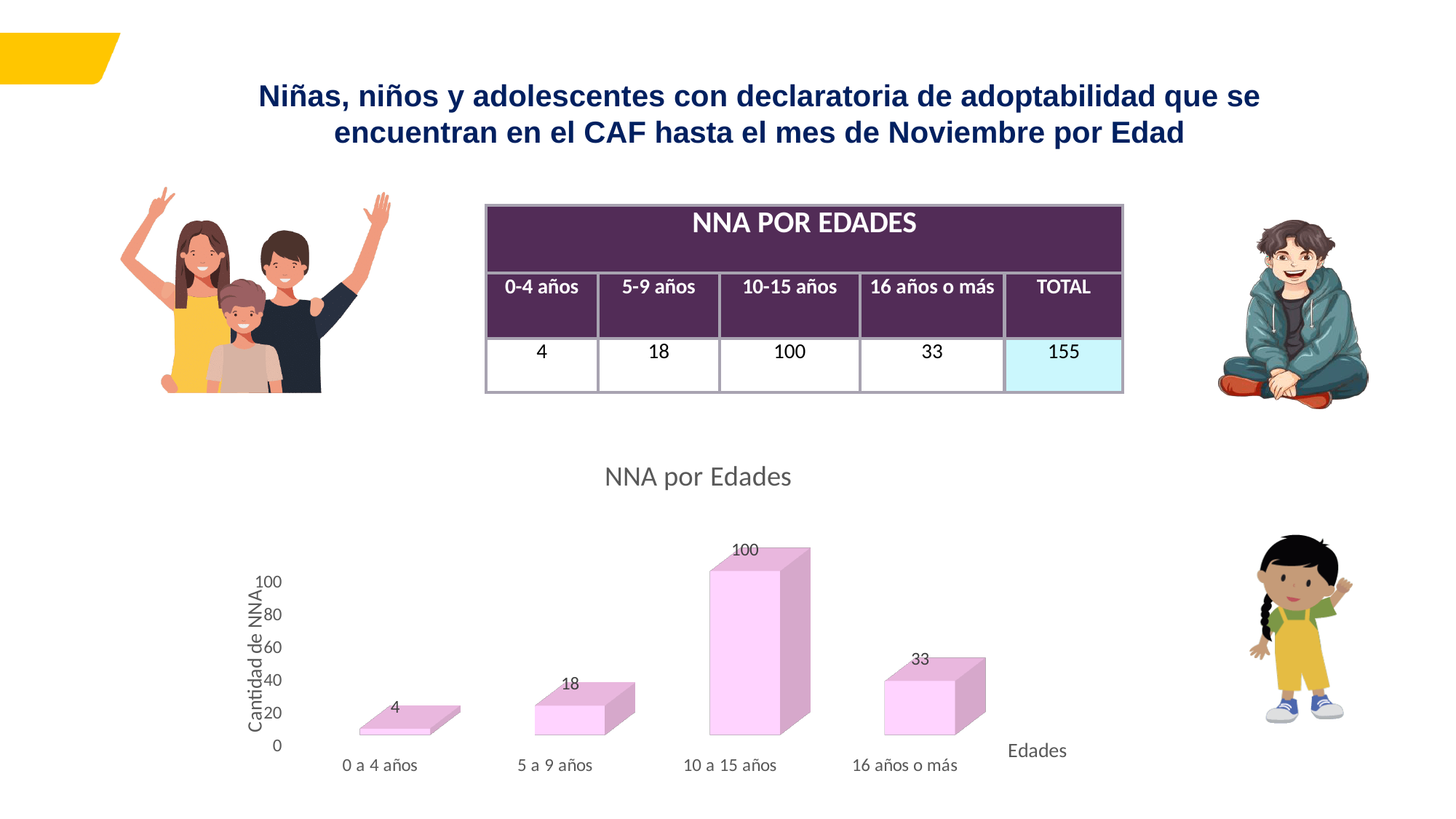
What is the label of the vertical axis of the chart? Cantidad de NNA How many age categories are shown in the chart? 4 What is the title of the chart? NNA por Edades Which is larger, the value for '5 a 9 años' or '16 años o más'? 16 años o más What is the value for '0 a 4 años' in the chart? 4 What is the value for '10 a 15 años' in the chart? 100 Which age group has the highest value in the chart? 10 a 15 años Is the value for '5 a 9 años' greater or less than 40? less What kind of chart is shown on the slide? bar chart What is the difference between the values for '10 a 15 años' and '16 años o más'? 67 Which age group has the lowest value in the chart? 0 a 4 años What is the value for '16 años o más' in the chart? 33